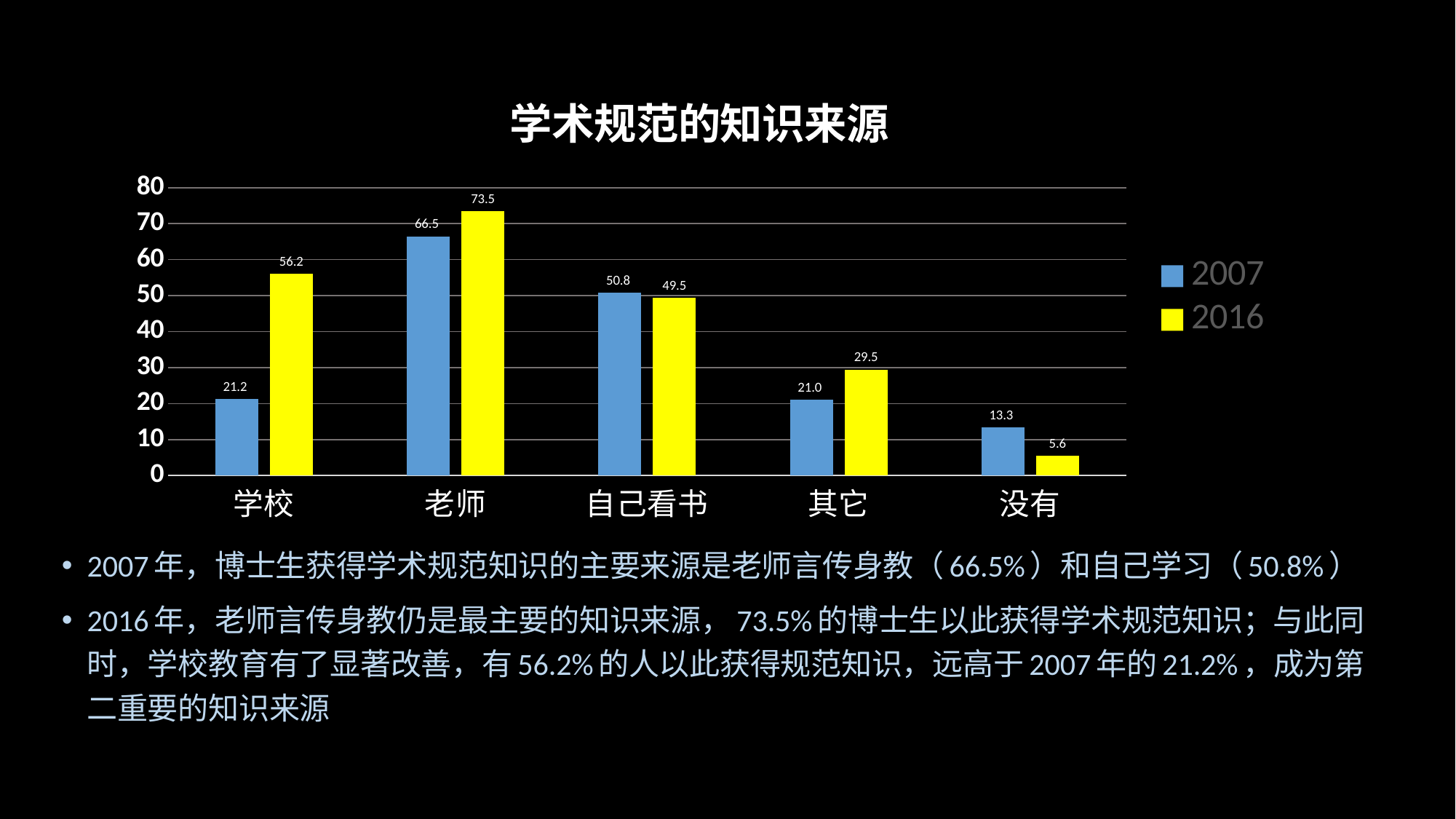
What is the value for 老师 in the 2016 series? 73.5 What is the value for 没有 in the 2016 series? 5.6 What kind of chart is shown on the slide? bar chart How many series does the legend list? 2 What is the value for 学校 in the 2007 series? 21.2 Which category has the highest value in the 2016 series? 老师 Which category has the lowest value in the 2007 series? 没有 Which is larger for 自己看书: the 2007 value or the 2016 value? 2007 How many categories are shown on the x axis? 5 What is the difference between the 2016 and 2007 values for 学校? 35.0 Which colour represents the 2016 series? yellow What is the title of the chart? 学术规范的知识来源